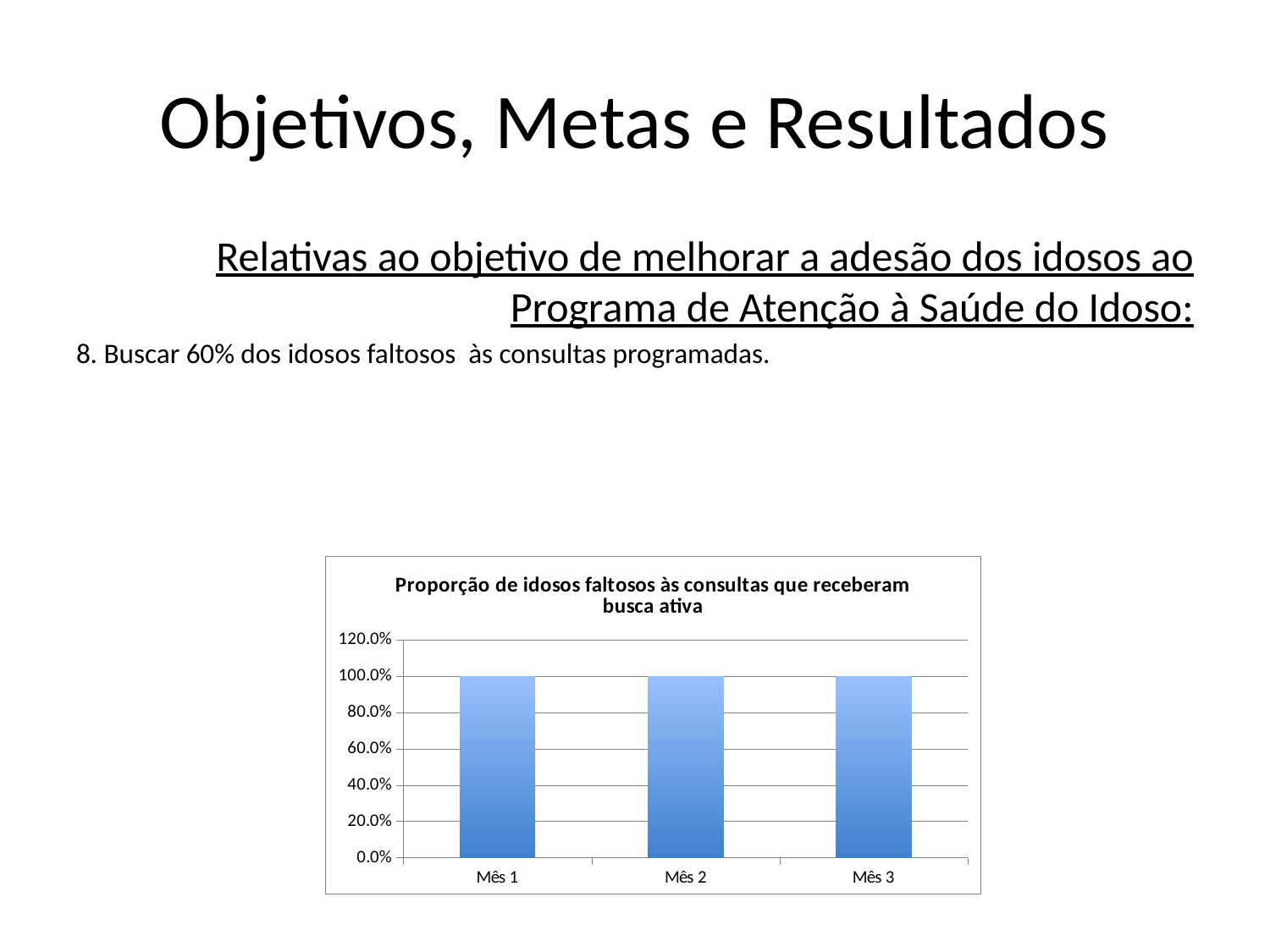
What is the value for Mês 1 in the chart? 100.0% What is the title of the chart? Proporção de idosos faltosos às consultas que receberam busca ativa How many categories (months) are shown on the x axis of the chart? 3 What is the highest value shown on the y axis of the chart? 120.0% What is the difference between the values for Mês 2 and Mês 1? 0.0% What kind of chart is shown on the slide? bar chart Is the value for Mês 3 greater or less than 60.0%? greater What is the value for Mês 2 in the chart? 100.0% Do the values rise, fall, or stay flat from Mês 1 to Mês 3? stay flat Is the value for Mês 1 greater or less than 80.0%? greater What is the value for Mês 3 in the chart? 100.0%